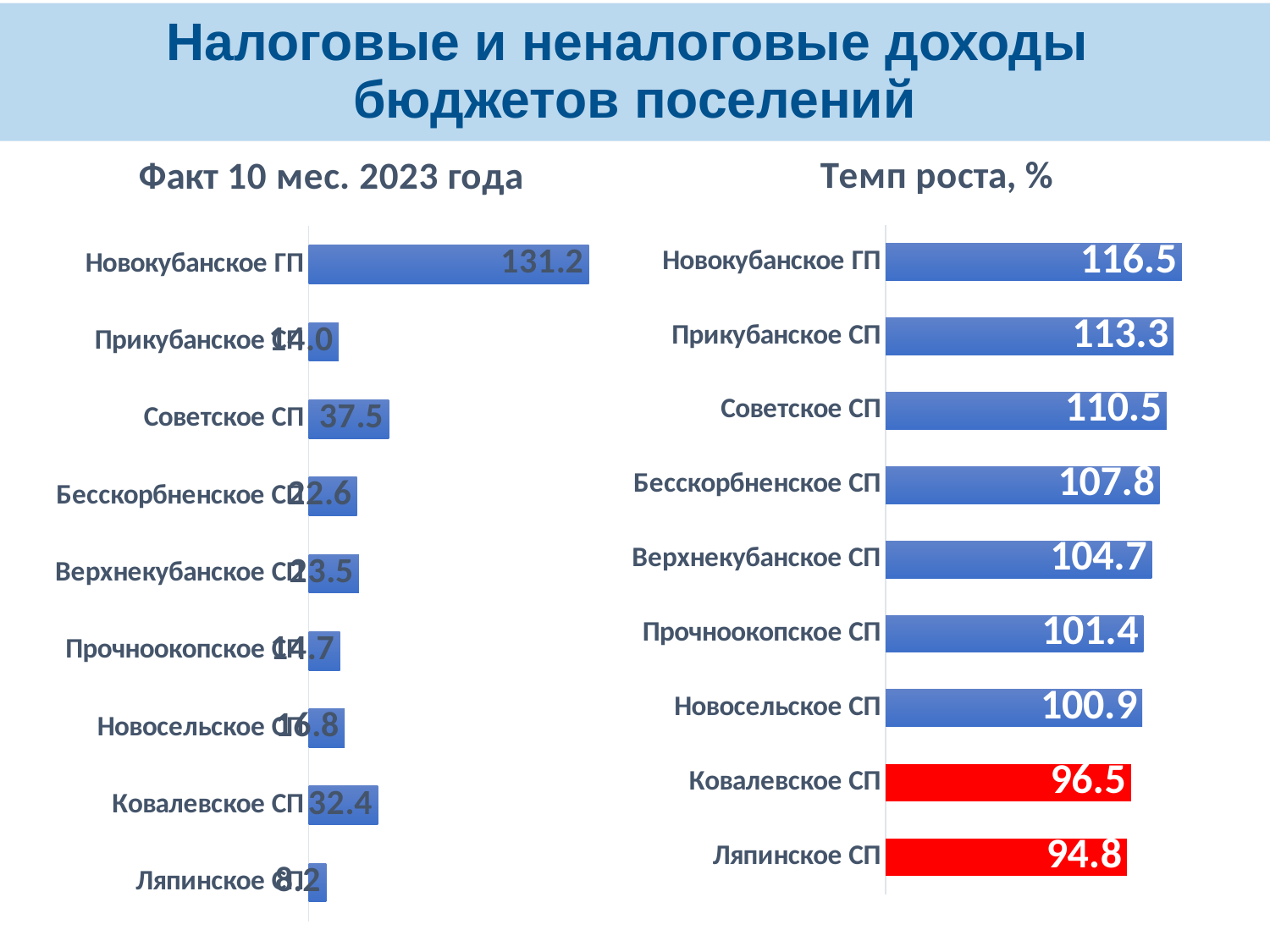
In the chart titled "Факт 10 мес. 2023 года", what is the value for Новокубанское ГП? 131.2 In the chart titled "Факт 10 мес. 2023 года", which is larger: the value for Советское СП or the value for Ковалевское СП? Советское СП In the chart titled "Темп роста, %", what is the difference between the values for Новокубанское ГП and Ляпинское СП? 21.7 In the chart titled "Темп роста, %", what is the value for Ляпинское СП? 94.8 In the chart titled "Темп роста, %", what is the value for Новокубанское ГП? 116.5 In the chart titled "Факт 10 мес. 2023 года", which category has the highest value? Новокубанское ГП What type of chart is the chart titled "Факт 10 мес. 2023 года"? bar chart In the chart titled "Факт 10 мес. 2023 года", what is the value for Советское СП? 37.5 How many categories are shown in the chart titled "Темп роста, %"? 9 In the chart titled "Темп роста, %", what is the value for Верхнекубанское СП? 104.7 In the chart titled "Темп роста, %", which category has the lowest value? Ляпинское СП In the chart titled "Темп роста, %", which categories have red bars? Ковалевское СП and Ляпинское СП